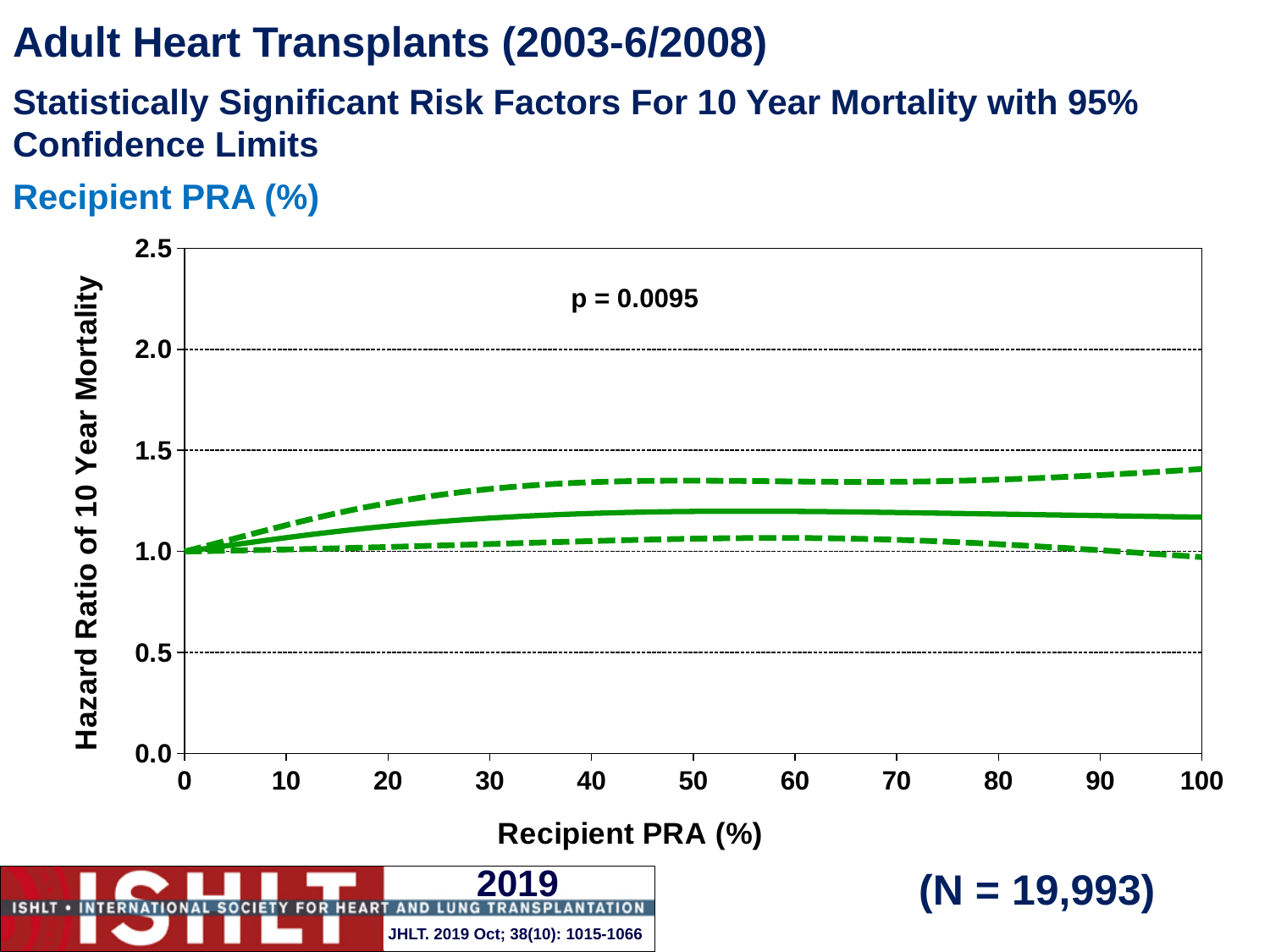
Is the upper confidence limit (upper dashed line) at a recipient PRA of 100% greater or less than 1.5? less Does the hazard ratio (solid line) rise or fall as recipient PRA increases from 0% to 50%? rise What is the highest value shown on the y axis of the chart? 2.5 Is the upper confidence limit (upper dashed line) at a recipient PRA of 100% greater or less than 1.0? greater What kind of chart is shown on the slide? line chart Is the lower confidence limit (lower dashed line) at a recipient PRA of 100% greater or less than 0.5? greater What is the hazard ratio of 10 year mortality at a recipient PRA of 0%? 1.0 What p-value is printed on the chart? p = 0.0095 How many lines are plotted on the chart? 3